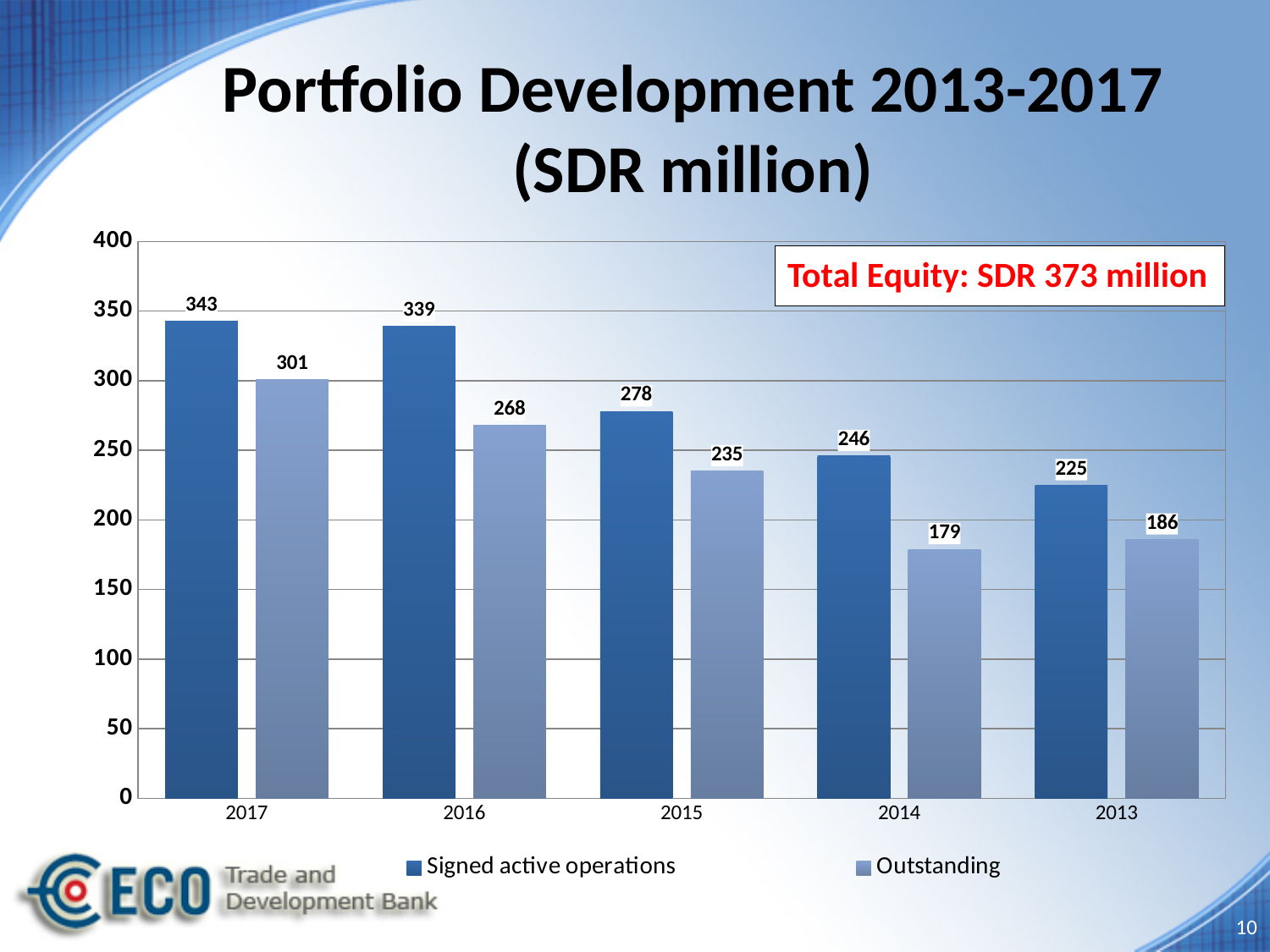
Which year has the highest Signed active operations value? 2017 What is the value of Signed active operations for 2017? 343 Which is larger: the Outstanding value for 2013 or the Outstanding value for 2014? 2013 How many series does the legend list? 2 What is the difference between the Signed active operations values for 2017 and 2013? 118 What total equity figure is stated in the text box on the chart? SDR 373 million What kind of chart is shown on the slide? Bar chart What is the Outstanding value for 2014? 179 What is the difference between Signed active operations and Outstanding in 2015? 43 What is the Outstanding value for 2016? 268 How many years are shown on the x axis? 5 Which year has the lowest Outstanding value? 2014